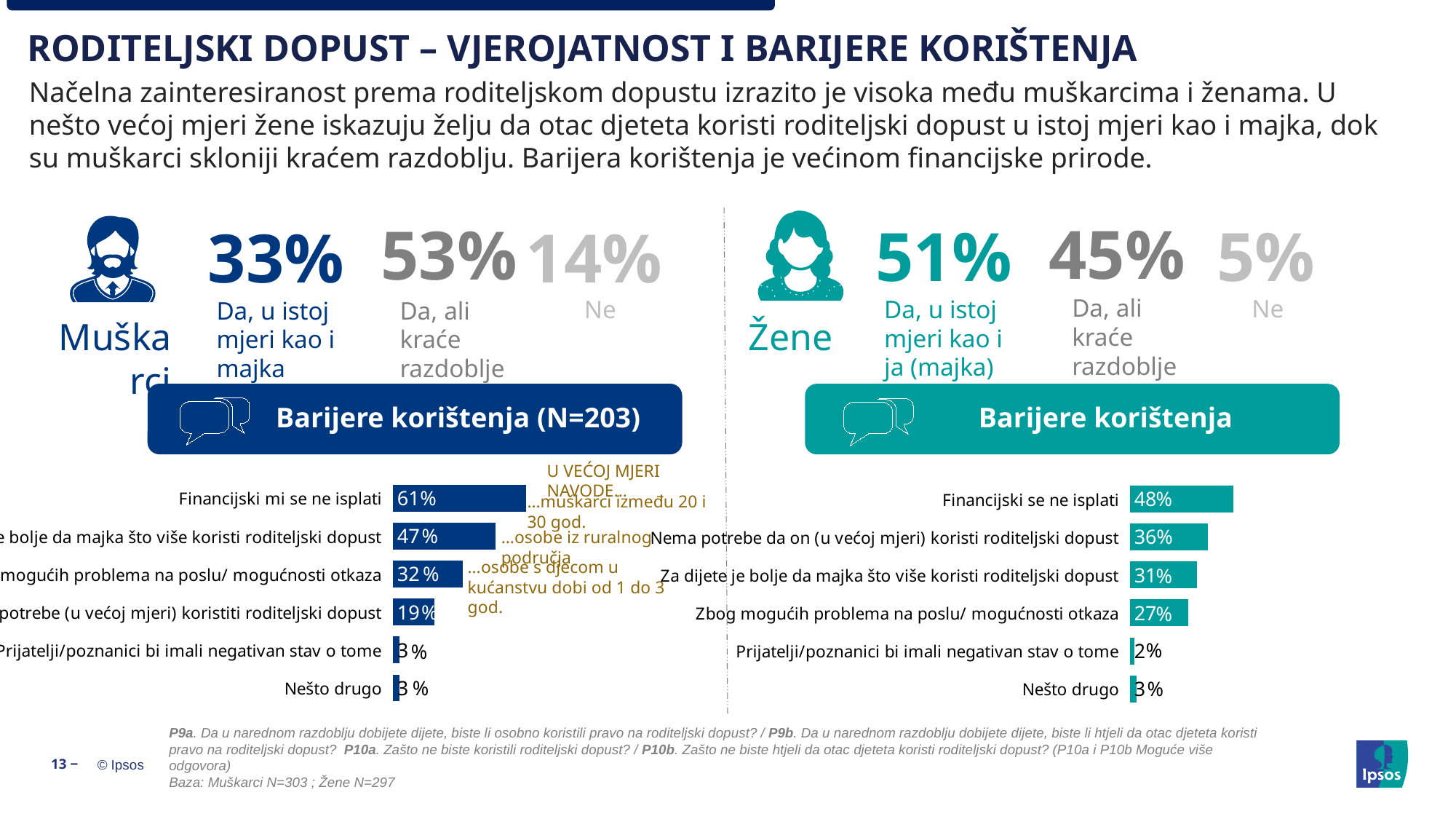
In the right chart 'Barijere korištenja' (women), what is the value for 'Zbog mogućih problema na poslu/ mogućnosti otkaza'? 27% In the right chart 'Barijere korištenja' (women), what is the value for 'Financijski se ne isplati'? 48% In the left chart 'Barijere korištenja (N=203)', which category has the highest value? Financijski mi se ne isplati What colour are the bars in the right chart 'Barijere korištenja' (women)? Teal Which is larger: 'Prijatelji/poznanici bi imali negativan stav o tome' in the left chart or in the right chart? Left chart (3% vs 2%) In the right chart 'Barijere korištenja' (women), what is the value for 'Nema potrebe da on (u većoj mjeri) koristi roditeljski dopust'? 36% In the left chart 'Barijere korištenja (N=203)', what is the value for 'Financijski mi se ne isplati'? 61% In the right chart 'Barijere korištenja' (women), which category has the lowest value? Prijatelji/poznanici bi imali negativan stav o tome How many categories are shown in the right chart 'Barijere korištenja' (women)? 6 What type of chart is used for 'Barijere korištenja' on the slide? Bar chart In the right chart 'Barijere korištenja' (women), what is the difference between 'Financijski se ne isplati' and 'Za dijete je bolje da majka što više koristi roditeljski dopust'? 17 percentage points What is the difference between 'Financijski mi se ne isplati' in the left chart (61%) and 'Financijski se ne isplati' in the right chart (48%)? 13 percentage points